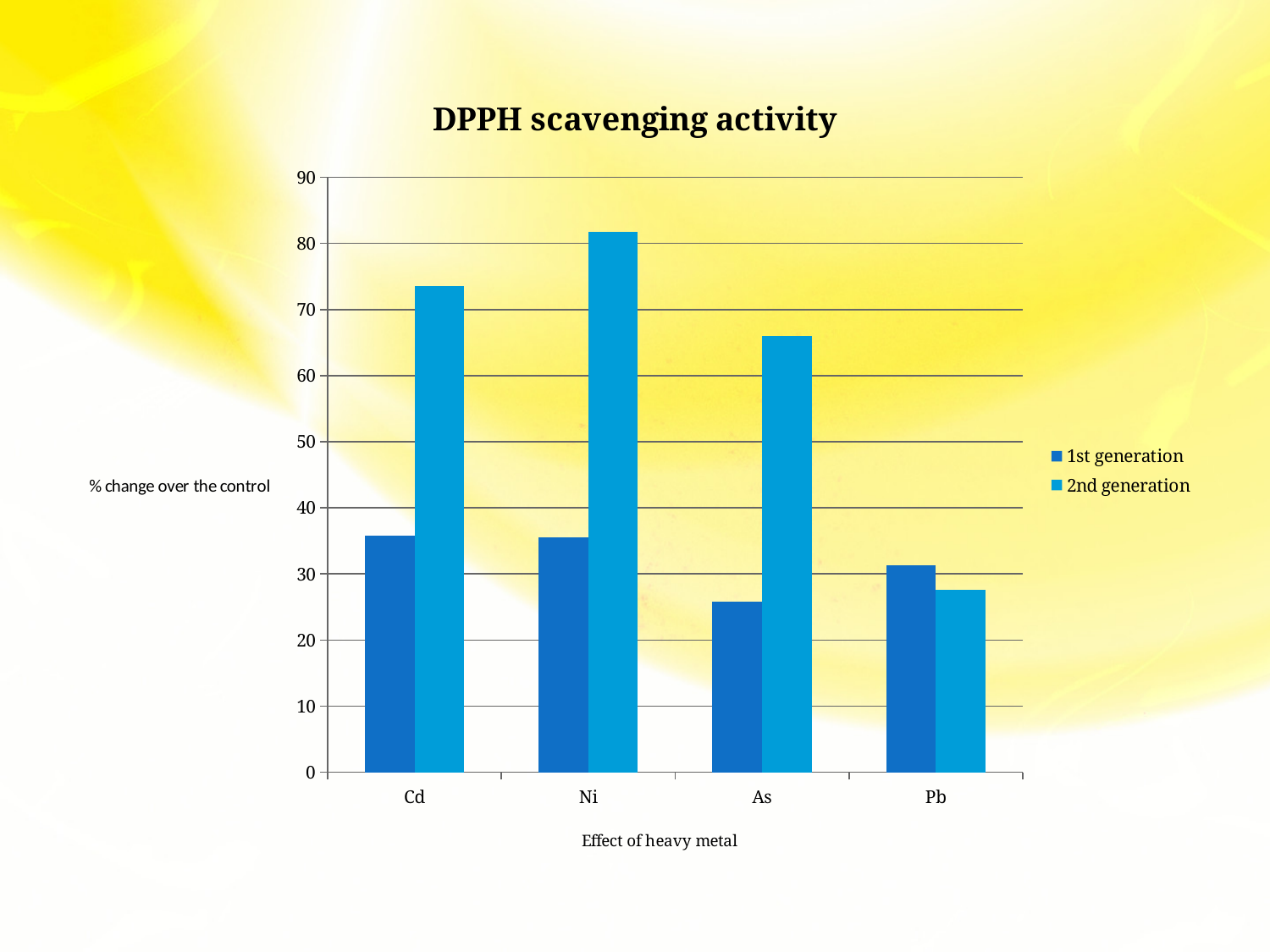
Is the 2nd generation value for As greater or less than 70? less Is the 2nd generation value for Pb greater or less than 30? less Is the 1st generation value for As greater or less than 20? greater For Pb, which is larger: the 1st generation value or the 2nd generation value? 1st generation How many series does the legend list? 2 What kind of chart is shown on the slide? bar chart What is the title of the chart? DPPH scavenging activity Which heavy metal has the lowest 2nd generation value? Pb How many heavy metal categories are shown on the x axis? 4 Which heavy metal has the lowest 1st generation value? As Which heavy metal has the highest 2nd generation value? Ni